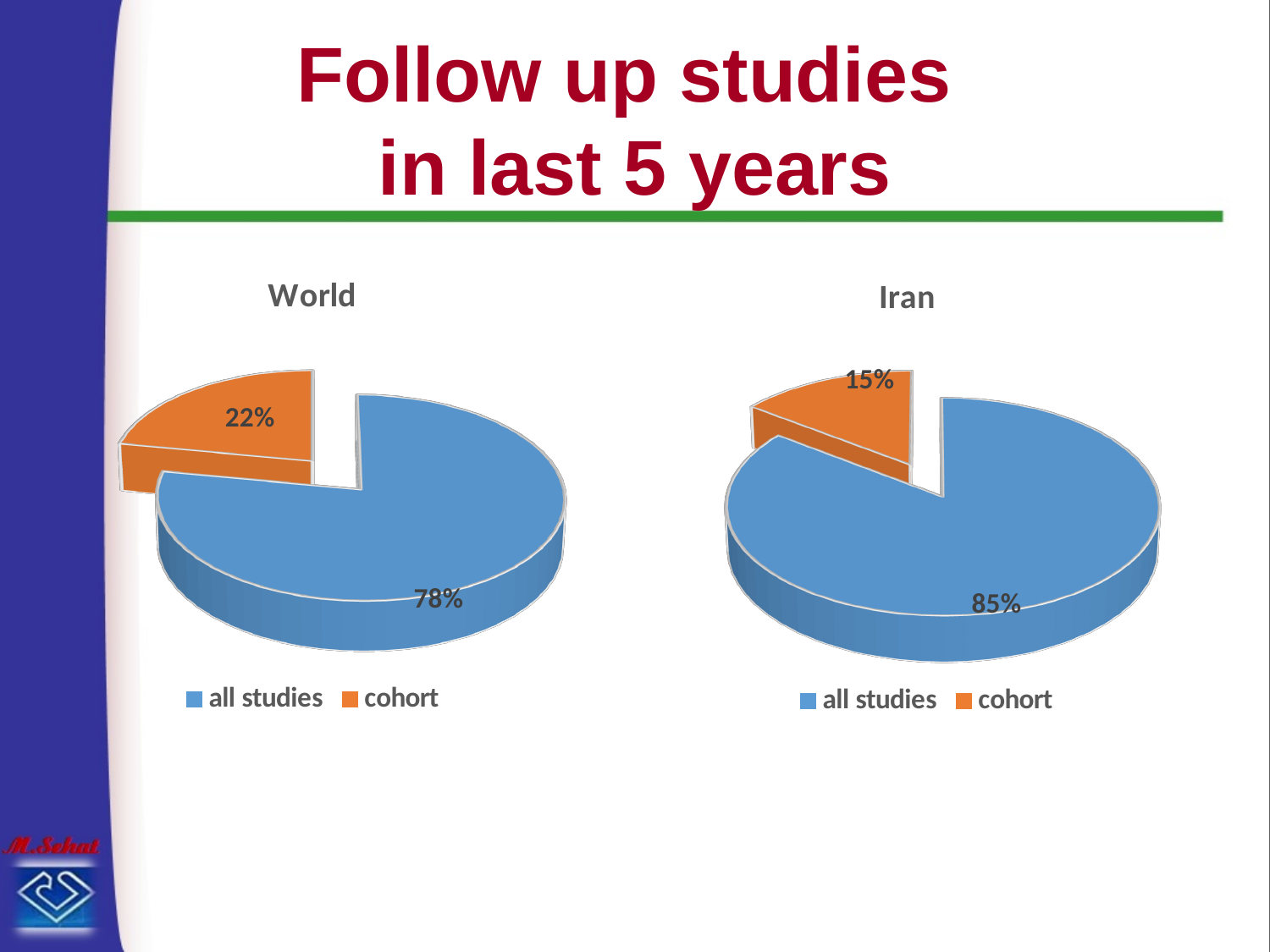
Is the cohort share larger in the World chart or the Iran chart? World In the World chart, which slice is the largest? all studies What type of chart is the World chart? pie chart In the World chart, what percentage is shown for all studies? 78% In the World chart, what percentage is shown for cohort? 22% In the World chart, what is the difference between the all studies and cohort percentages? 56% In the Iran chart, what percentage is shown for all studies? 85% In the Iran chart, what percentage is shown for cohort? 15% In the Iran chart, what colour is the cohort slice? orange How many entries does the legend of the World chart list? 2 In the Iran chart, which slice is the smallest? cohort How many slices does the Iran chart have? 2